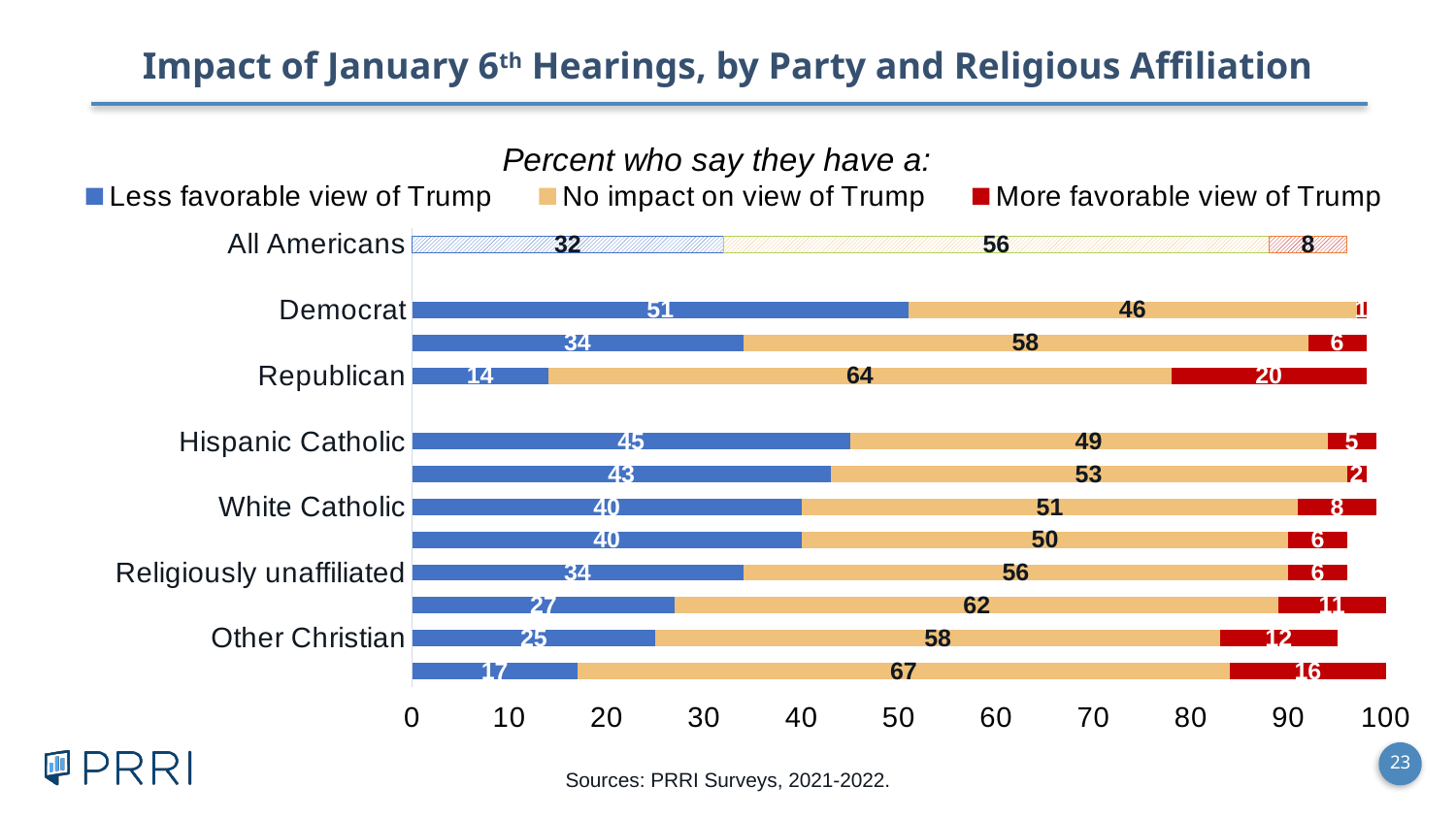
What percentage of Other Christians say they have a more favorable view of Trump? 12 What kind of chart is shown on the slide? Stacked bar chart Which labeled group has the lowest share saying they have a less favorable view of Trump? Republican What percentage of Republicans say they have a more favorable view of Trump? 20 What percentage of Democrats say they have a less favorable view of Trump? 51 What is the total of the three segments in the Republican bar? 98 How many series does the legend list? 3 What is the difference between Democrats and Republicans in the share with a less favorable view of Trump? 37 Which labeled group has the highest share saying they have a less favorable view of Trump? Democrat Who has a larger share with a less favorable view of Trump, Hispanic Catholics or White Catholics? Hispanic Catholic What percentage of Republicans say they have a less favorable view of Trump? 14 What percentage of All Americans say the hearings had no impact on their view of Trump? 56